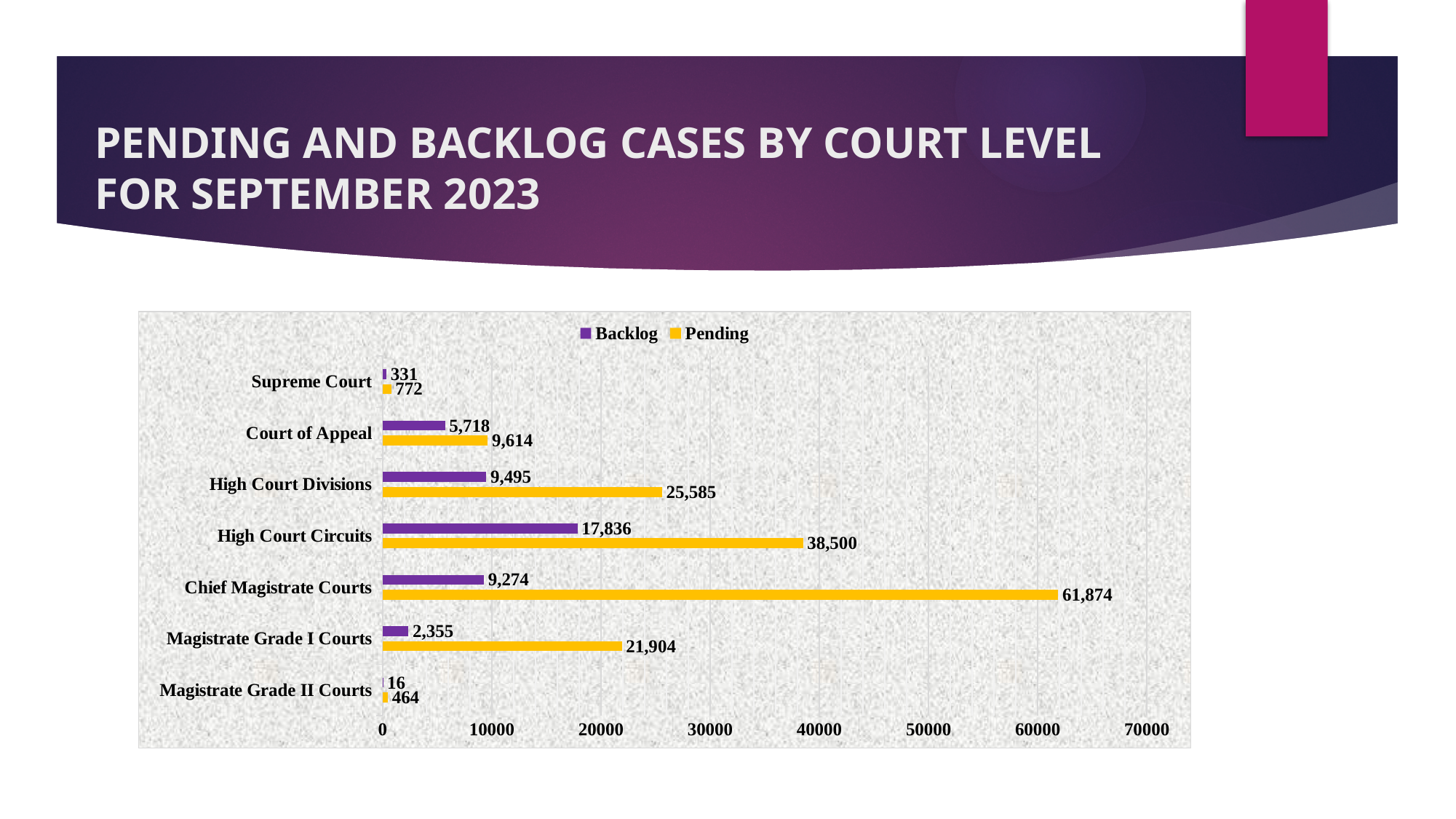
What is the difference between the Pending and Backlog values for High Court Divisions? 16,090 Which court level has the highest Pending value? Chief Magistrate Courts Is the Pending value for High Court Circuits greater or less than 40000? less How many court levels are shown on the chart? 7 What is the Backlog value for High Court Circuits? 17,836 What is the Pending value for Magistrate Grade I Courts? 21,904 How many series does the legend list? 2 What is the Pending value for Chief Magistrate Courts? 61,874 Which is larger, the Backlog value for High Court Divisions or the Backlog value for Chief Magistrate Courts? High Court Divisions Which colour represents the Pending series in the chart? Yellow Which court level has the lowest Backlog value? Magistrate Grade II Courts What kind of chart is shown on the slide? Bar chart